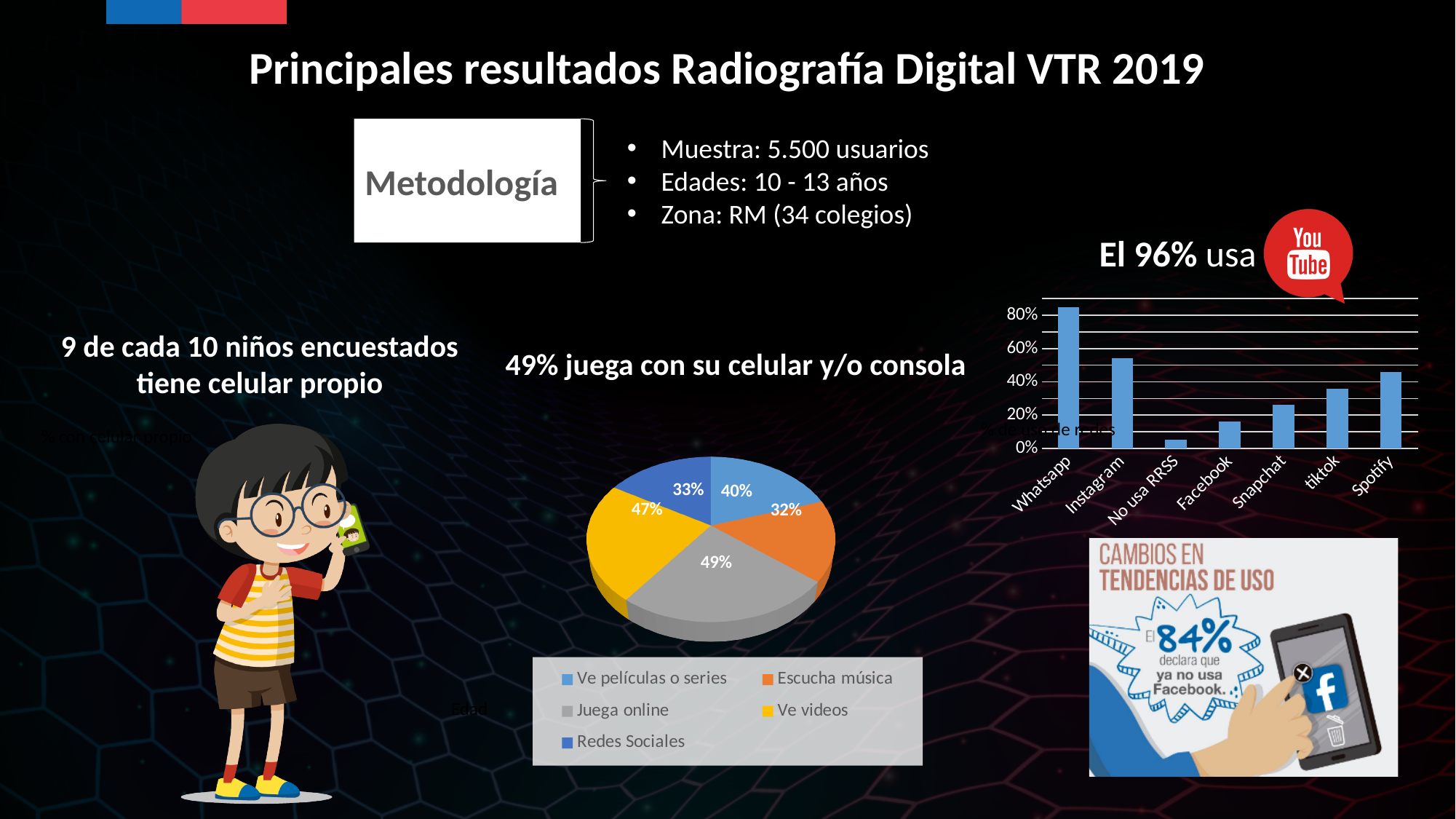
In the pie chart, which activity has the highest percentage? Juega online In the bar chart on the right, which category has the highest bar? Whatsapp In the bar chart on the right, which category has the lowest bar? No usa RRSS In the pie chart, what percentage is shown for Ve videos? 47% In the pie chart, what percentage is shown for Juega online? 49% In the pie chart, what percentage is shown for Redes Sociales? 33% In the bar chart on the right, which is larger, Instagram or Spotify? Instagram In the pie chart, what percentage is shown for Escucha música? 32% In the bar chart on the right, is the value for Facebook greater or less than 20%? less In the bar chart on the right, is the value for Whatsapp greater or less than 80%? greater In the pie chart, how many activities does the legend list? 5 In the bar chart on the right, how many categories are shown on the x axis? 7